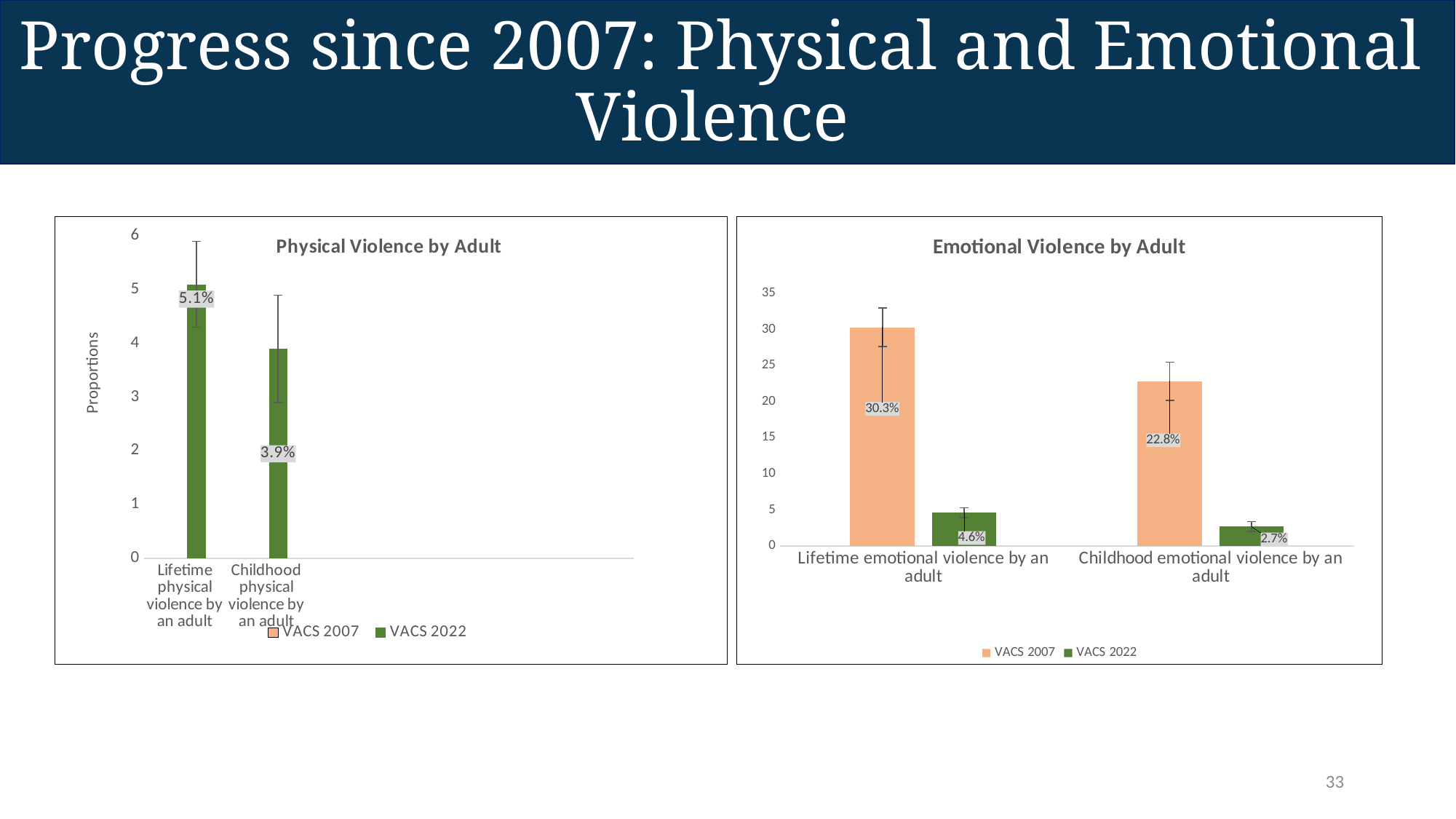
What kind of chart is the Physical Violence by Adult chart? Bar chart In the Emotional Violence by Adult chart, what is the VACS 2022 value for childhood emotional violence by an adult? 2.7% In the Emotional Violence by Adult chart, what is the difference between the VACS 2007 and VACS 2022 values for lifetime emotional violence by an adult? 25.7% In the Physical Violence by Adult chart, what is the difference between the lifetime and childhood values? 1.2% In the Physical Violence by Adult chart, what is the value for lifetime physical violence by an adult? 5.1% In the Emotional Violence by Adult chart, which bar is the lowest? VACS 2022, childhood emotional violence by an adult How many series does the legend of the Emotional Violence by Adult chart list? 2 In the Emotional Violence by Adult chart, what is the VACS 2007 value for childhood emotional violence by an adult? 22.8% In the Physical Violence by Adult chart, which category has the higher value? Lifetime physical violence by an adult In the Emotional Violence by Adult chart, is the VACS 2007 value for lifetime emotional violence by an adult greater or less than 25? greater In the Emotional Violence by Adult chart, what is the VACS 2007 value for lifetime emotional violence by an adult? 30.3% In the Physical Violence by Adult chart, what is the value for childhood physical violence by an adult? 3.9%